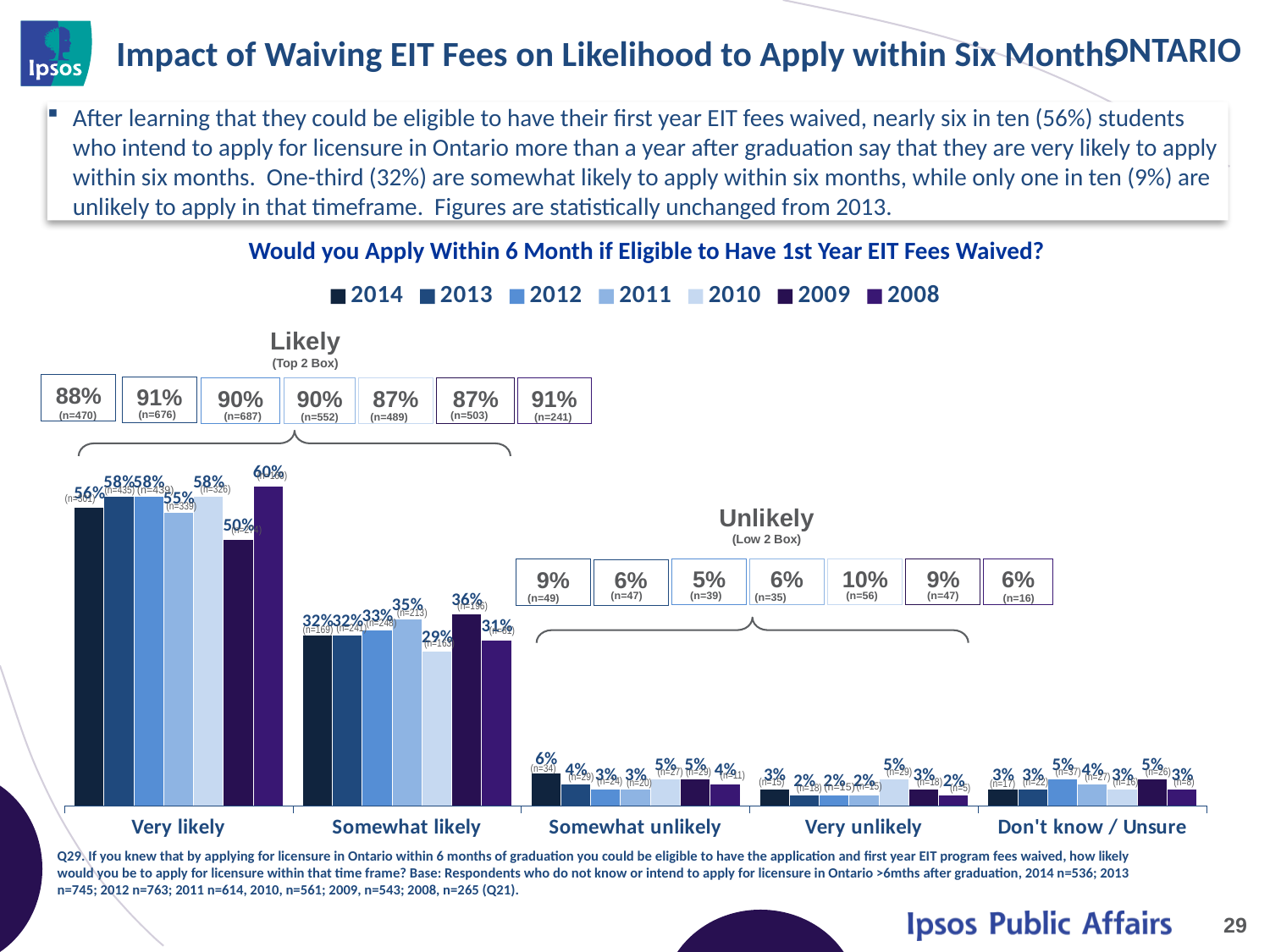
How many response categories are shown on the x axis? 5 What is the 'Likely (Top 2 Box)' figure shown for 2014? 88% What percentage of respondents in 2014 said they were very likely to apply within six months? 56% What is the 'Unlikely (Low 2 Box)' figure shown for 2010? 10% Which year has the highest value in the 'Very likely' category? 2008 What is the difference between the 2008 and 2009 values for 'Very likely'? 10 percentage points Which year has the lowest value in the 'Very likely' category? 2009 How many years (series) does the legend list? 7 Which is larger for 2014: the 'Somewhat unlikely' value or the 'Very unlikely' value? Somewhat unlikely What is the 2010 value for 'Very unlikely'? 5% What type of chart is used on this slide? Bar chart What is the 2009 value for the 'Somewhat likely' category? 36%